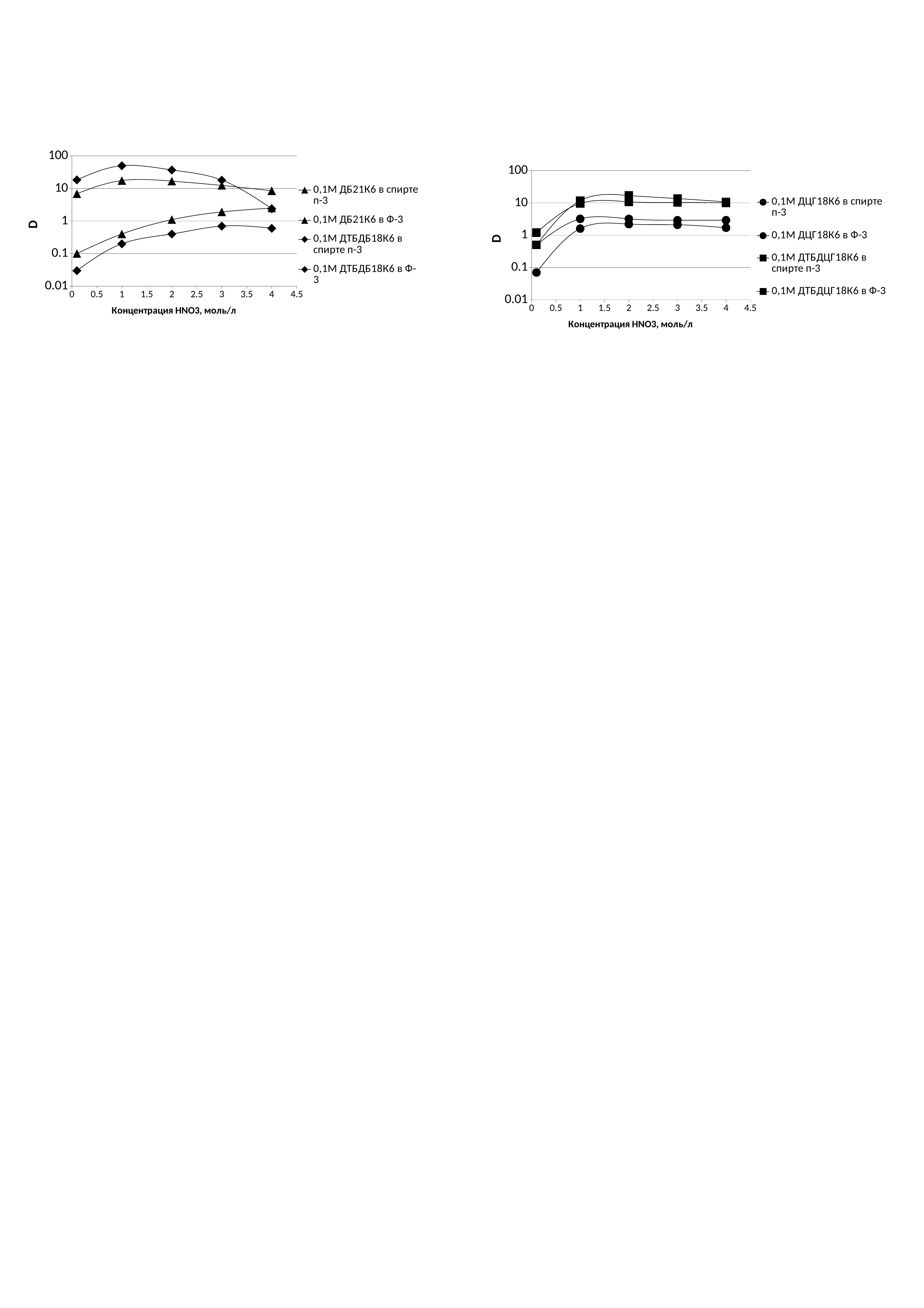
How many series does the legend of the right chart list? 4 What is the highest tick value shown on the y axis of the right chart? 100 On the left chart, is the highest plotted value greater or less than 10? greater On the left chart, is the lowest plotted value greater or less than 0.1? less On the right chart, is the lowest plotted value greater or less than 0.1? less How many series does the legend of the left chart list? 4 What is the x-axis title of the left chart? Концентрация HNO3, моль/л On the right chart, do the values of the series rise or fall between HNO3 concentration 0.1 and 1? rise What is the y-axis title of the right chart? D On the left chart, how many data points does each series have? 5 On the right chart, how many data points does each series have? 5 What kind of chart is the left chart? line chart